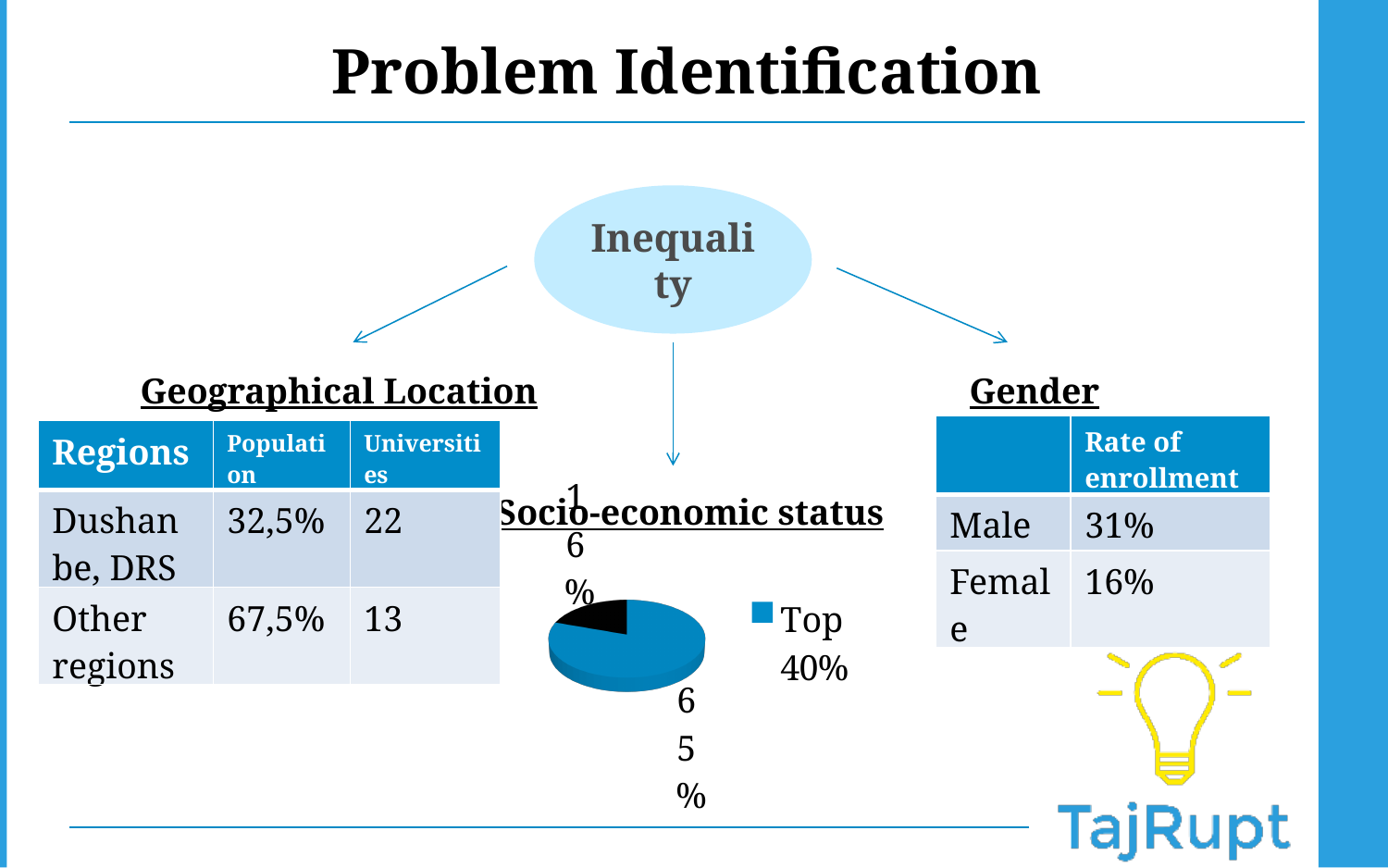
What kind of chart is shown under the heading "Socio-economic status"? Pie chart In the Socio-economic status pie chart, is the "Top 40%" slice larger or smaller than the black slice? Larger What colour is the "Top 40%" slice in the Socio-economic status pie chart? Blue In the Socio-economic status pie chart, what is the difference between the 65% slice and the 16% slice? 49 percentage points How many slices does the Socio-economic status pie chart have? 2 In the Socio-economic status pie chart, what value is shown for the "Top 40%" slice? 65% In the Socio-economic status pie chart, what is the value of the largest slice? 65% In the Socio-economic status pie chart, what share of the pie does the "Top 40%" slice represent? 65% In the Socio-economic status pie chart, what value is shown on the small black slice? 16% In the Socio-economic status pie chart, what is the value of the smallest slice? 16% What legend entry is readable next to the Socio-economic status pie chart? Top 40%